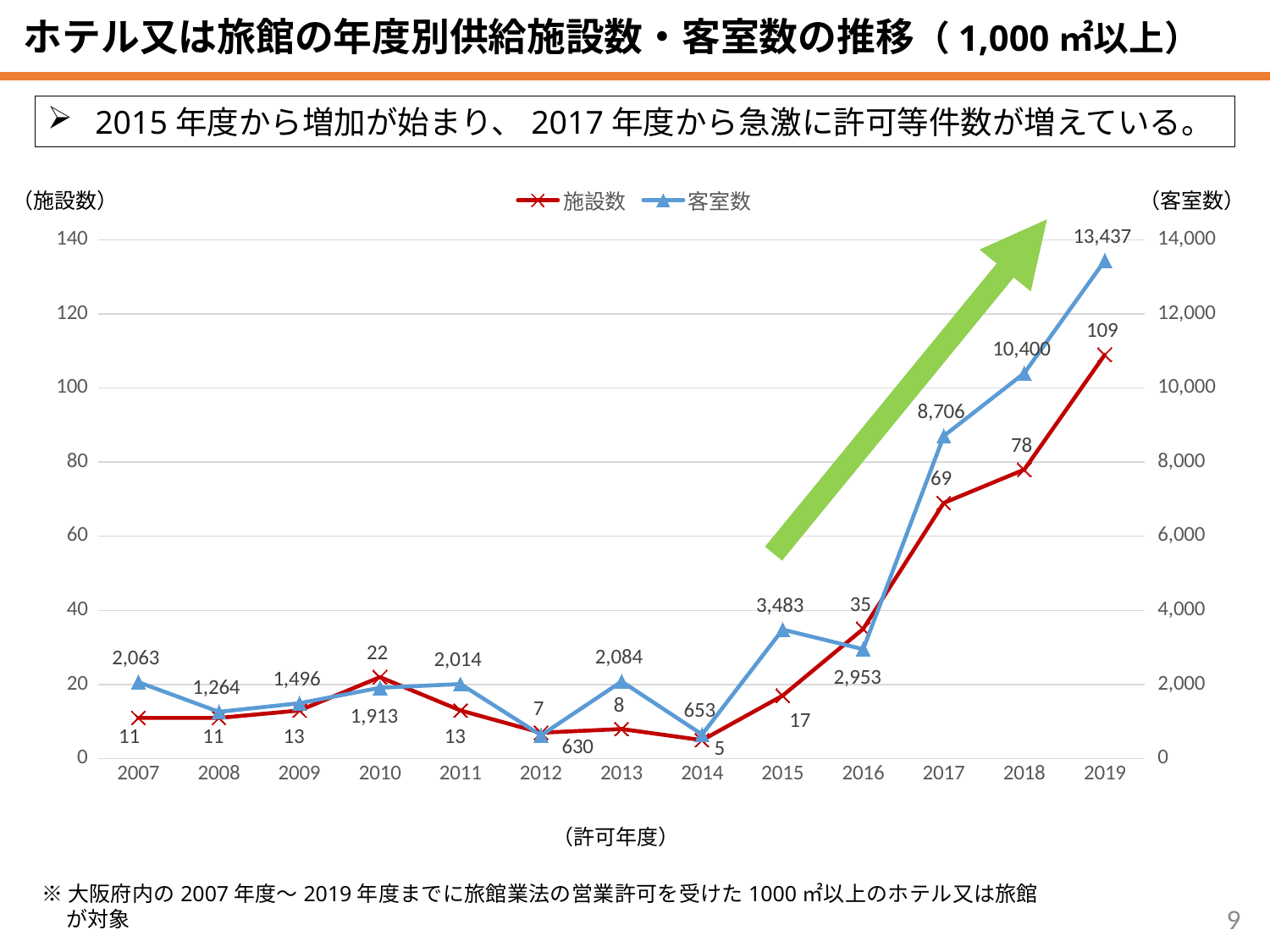
What is the difference between the 客室数 values for 2018 and 2017? 1,694 Which year has the highest 客室数 value? 2019 What is the 施設数 value for 2010? 22 What is the 客室数 value for 2012? 630 Which year has the lowest 施設数 value? 2014 What kind of chart is shown on the slide? Line chart Which is larger, the 客室数 value for 2015 or for 2016? 2015 What is the 施設数 value for 2019? 109 What is the difference between the 施設数 values for 2019 and 2018? 31 How many series does the legend list? 2 How many years are plotted on the x axis? 13 What is the 客室数 value for 2017? 8,706